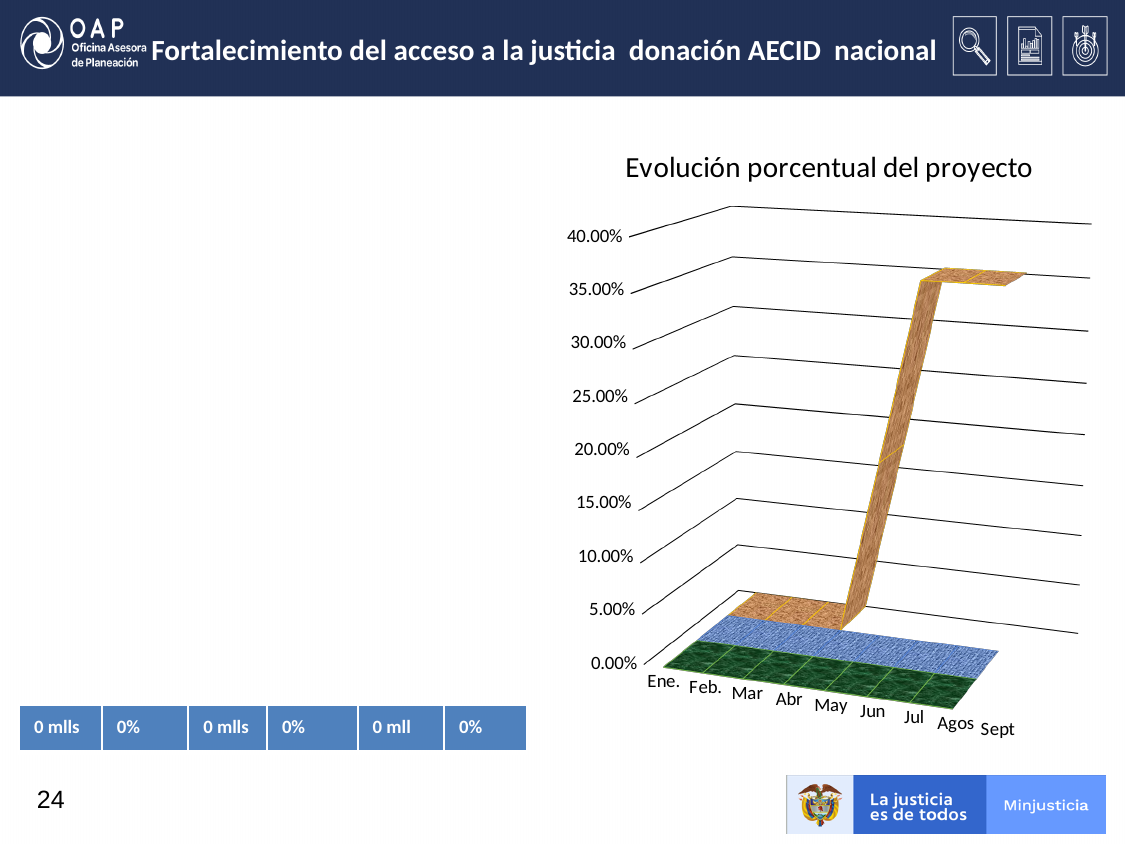
Do the values rise or fall from Jul to Agos? neither, they stay the same What is the highest tick value shown on the vertical axis of the chart? 40.00% What is the first category on the x axis of the chart? Ene. Is the value for Ene. greater or less than 5.00%? less What kind of chart is shown on the slide? line chart What is the title of the chart? Evolución porcentual del proyecto How many months are shown on the x axis of the chart? 9